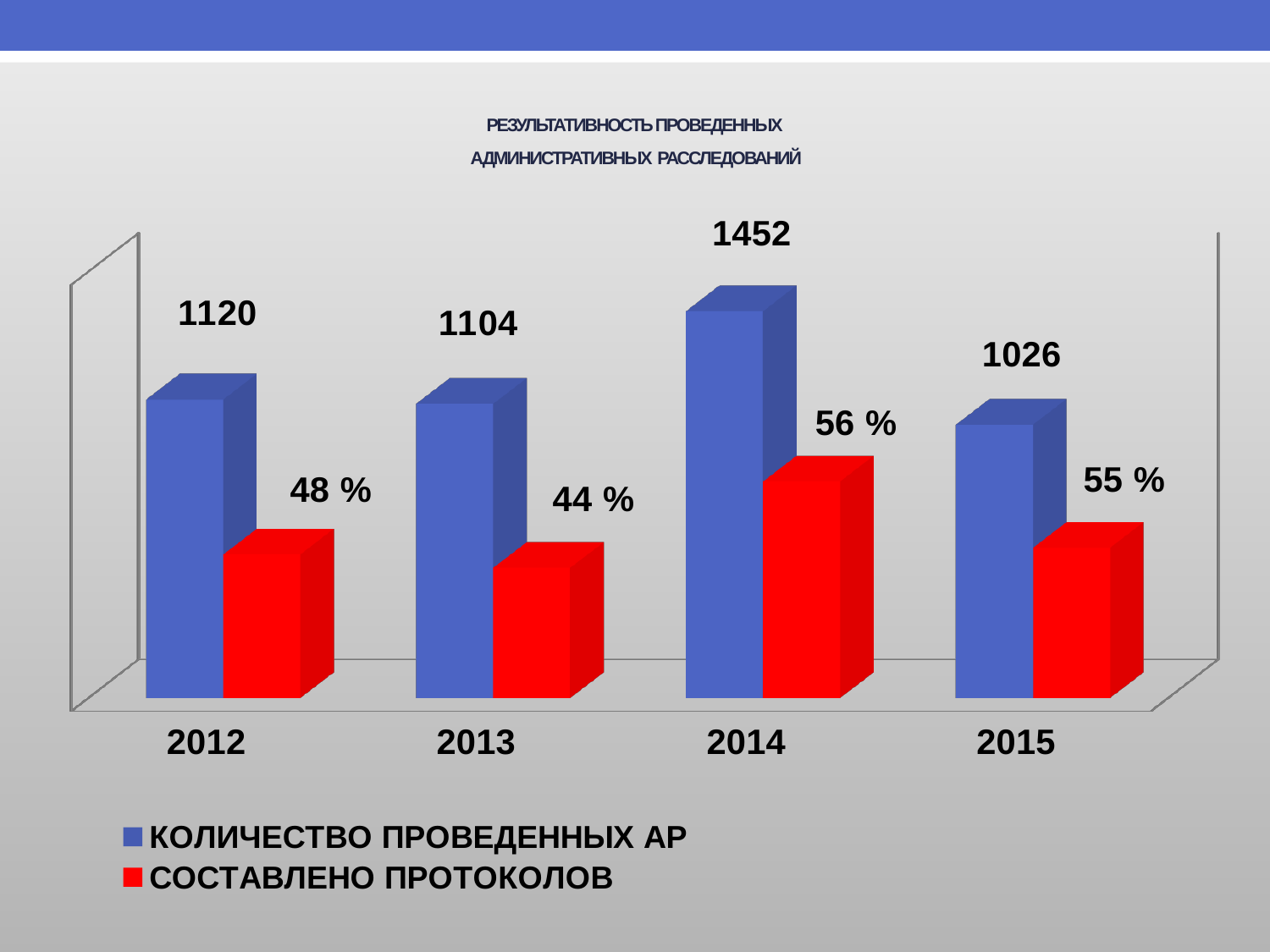
What kind of chart is shown on the slide? Bar chart What is the value for КОЛИЧЕСТВО ПРОВЕДЕННЫХ АР in 2015? 1026 What is the difference between КОЛИЧЕСТВО ПРОВЕДЕННЫХ АР in 2014 and in 2015? 426 How many series does the legend list? 2 What is the value for КОЛИЧЕСТВО ПРОВЕДЕННЫХ АР in 2014? 1452 In which year is the СОСТАВЛЕНО ПРОТОКОЛОВ percentage lowest? 2013 What label is shown on the СОСТАВЛЕНО ПРОТОКОЛОВ bar for 2013? 44 % In which year is КОЛИЧЕСТВО ПРОВЕДЕННЫХ АР lowest? 2015 In which year is КОЛИЧЕСТВО ПРОВЕДЕННЫХ АР highest? 2014 How many years are shown on the x axis? 4 Which year has the larger value for КОЛИЧЕСТВО ПРОВЕДЕННЫХ АР, 2012 or 2013? 2012 What label is shown on the СОСТАВЛЕНО ПРОТОКОЛОВ bar for 2014? 56 %